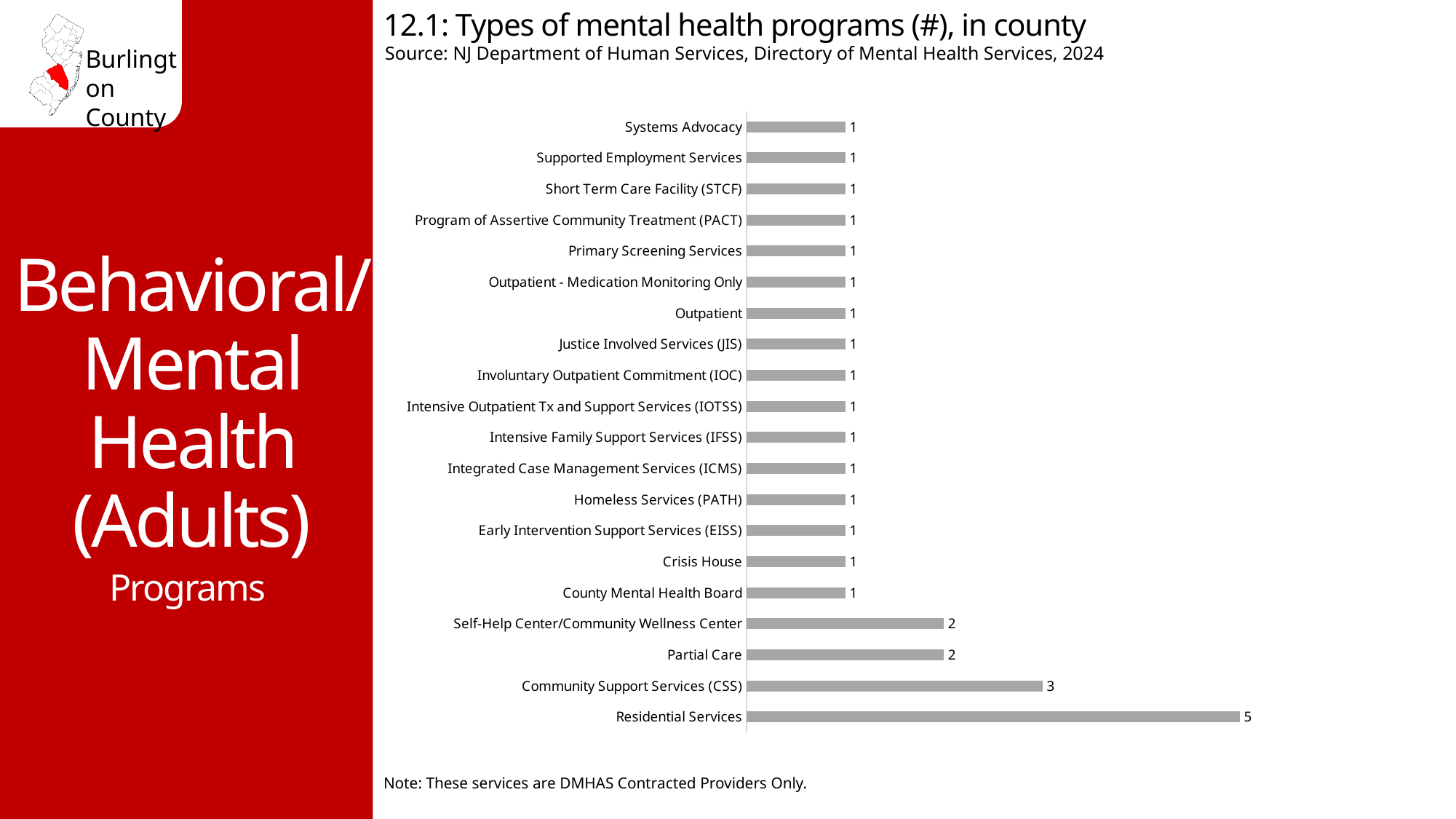
What is the number of Residential Services programs shown on the chart? 5 What value is shown for Partial Care? 2 Which has more programs, Community Support Services (CSS) or Self-Help Center/Community Wellness Center? Community Support Services (CSS) What value is shown for Crisis House? 1 What is the title of the chart? 12.1: Types of mental health programs (#), in county What is the difference between the value for Self-Help Center/Community Wellness Center and the value for Systems Advocacy? 1 What kind of chart is shown on the slide? Bar chart How many Community Support Services (CSS) programs are shown? 3 What is the difference between the number of Residential Services programs and Community Support Services (CSS) programs? 2 Which type of mental health program has the highest count? Residential Services How many types of mental health programs are listed on the chart? 20 Which has more programs, Partial Care or Outpatient? Partial Care